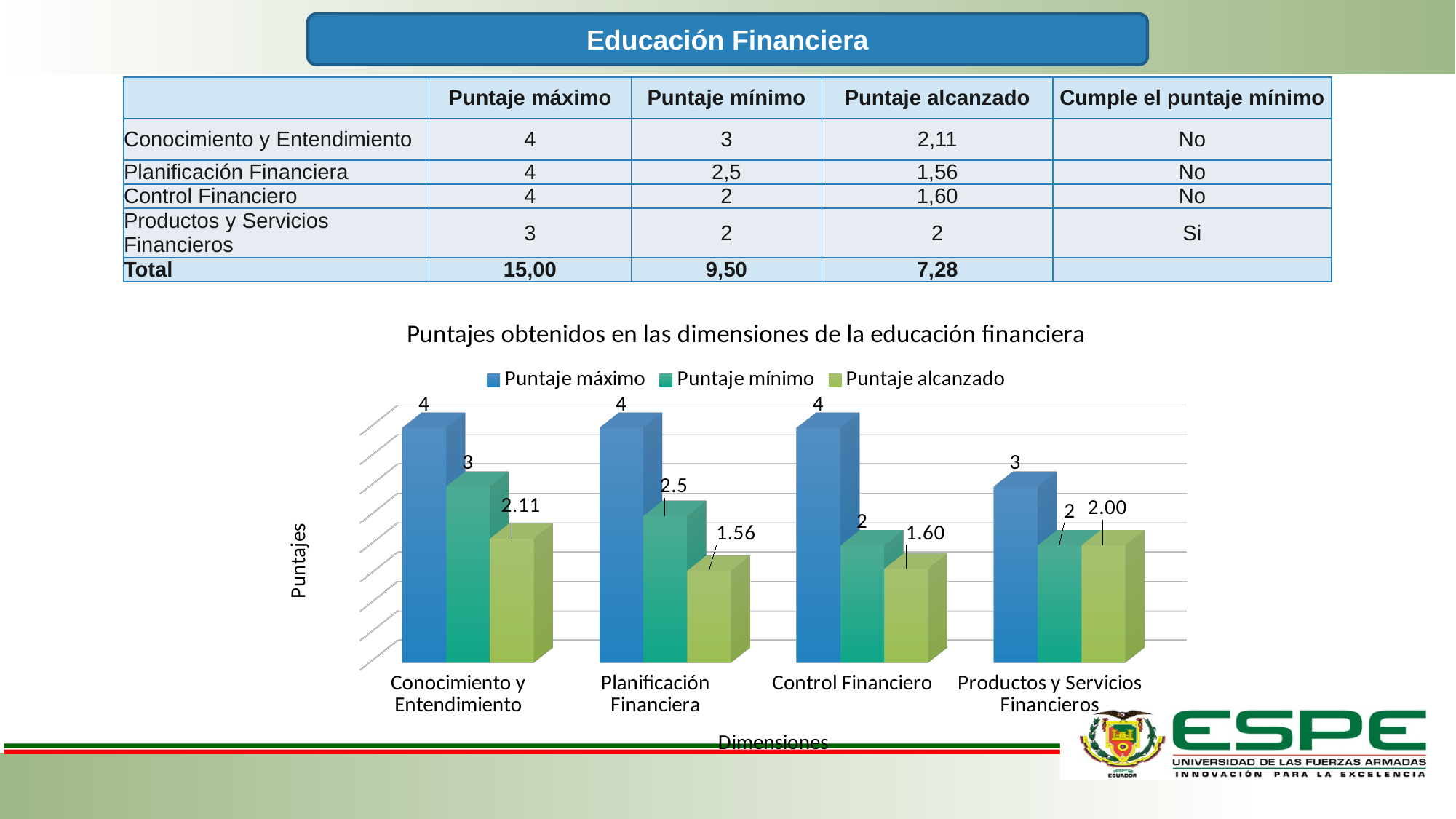
What is the Puntaje alcanzado value for Conocimiento y Entendimiento in the chart? 2.11 Which is larger for Planificación Financiera: the Puntaje mínimo or the Puntaje alcanzado? Puntaje mínimo What kind of chart is shown on the slide? Bar chart How many dimensions are shown on the x axis of the chart? 4 What is the difference between the Puntaje mínimo and the Puntaje alcanzado for Conocimiento y Entendimiento? 0.89 Which dimension has the highest Puntaje alcanzado in the chart? Conocimiento y Entendimiento What is the Puntaje mínimo value for Planificación Financiera in the chart? 2.5 What is the Puntaje máximo value for Productos y Servicios Financieros in the chart? 3 What is the Puntaje alcanzado value for Control Financiero in the chart? 1.60 What is the title of the chart? Puntajes obtenidos en las dimensiones de la educación financiera How many series does the chart legend list? 3 Which dimension has the lowest Puntaje alcanzado in the chart? Planificación Financiera